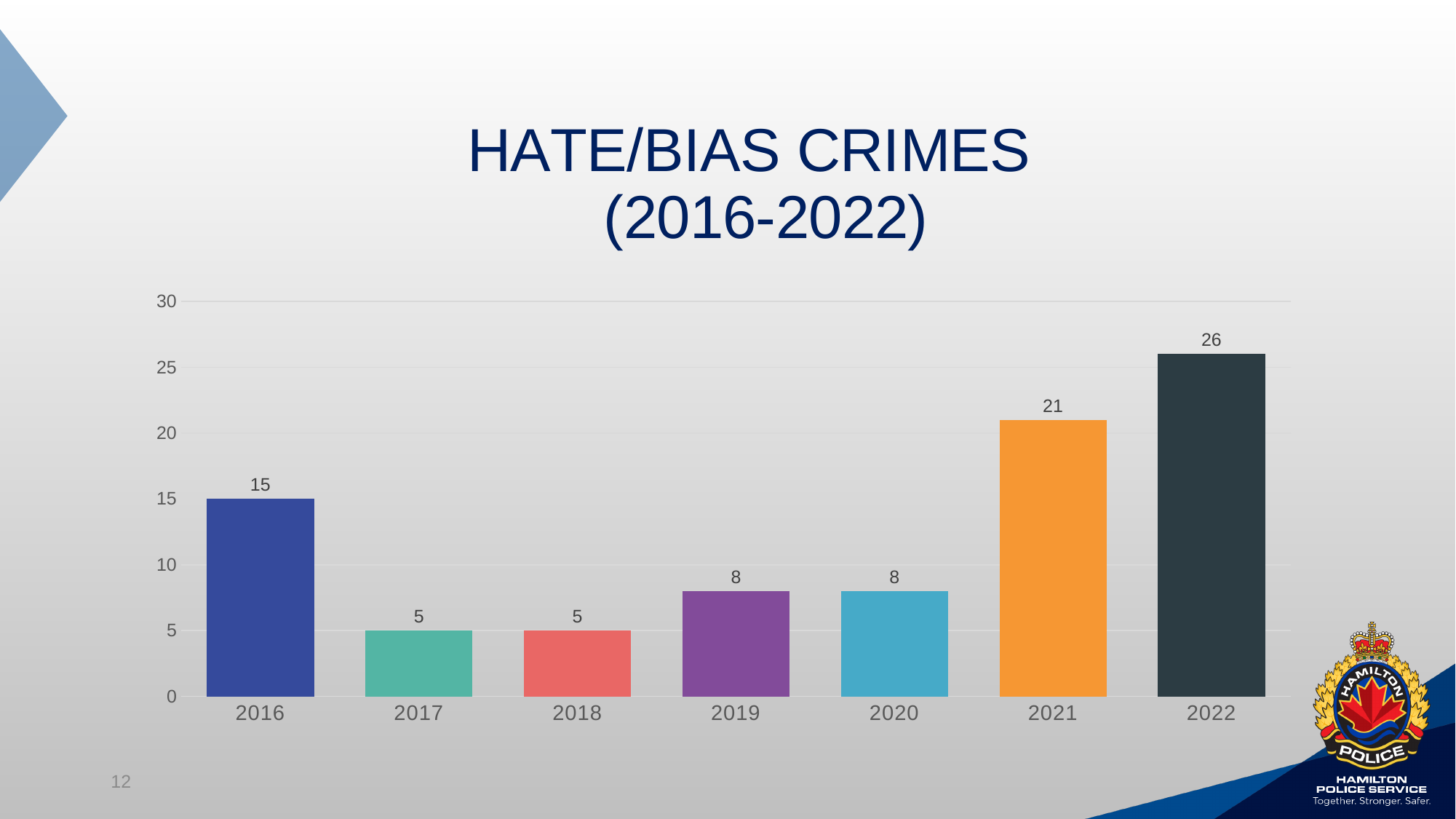
What is the title of the chart? HATE/BIAS CRIMES (2016-2022) What is the difference between the values for 2016 and 2017? 10 What is the difference between the values for 2022 and 2021? 5 Which is larger, the value for 2016 or the value for 2021? 2021 Is the value for 2021 greater or less than 20? greater What is the value for 2019? 8 What is the value for 2016? 15 Which year has the highest value? 2022 Do the values rise or fall from 2020 to 2022? Rise How many years are shown on the x axis? 7 What kind of chart is shown on the slide? Bar chart What is the value for 2022? 26